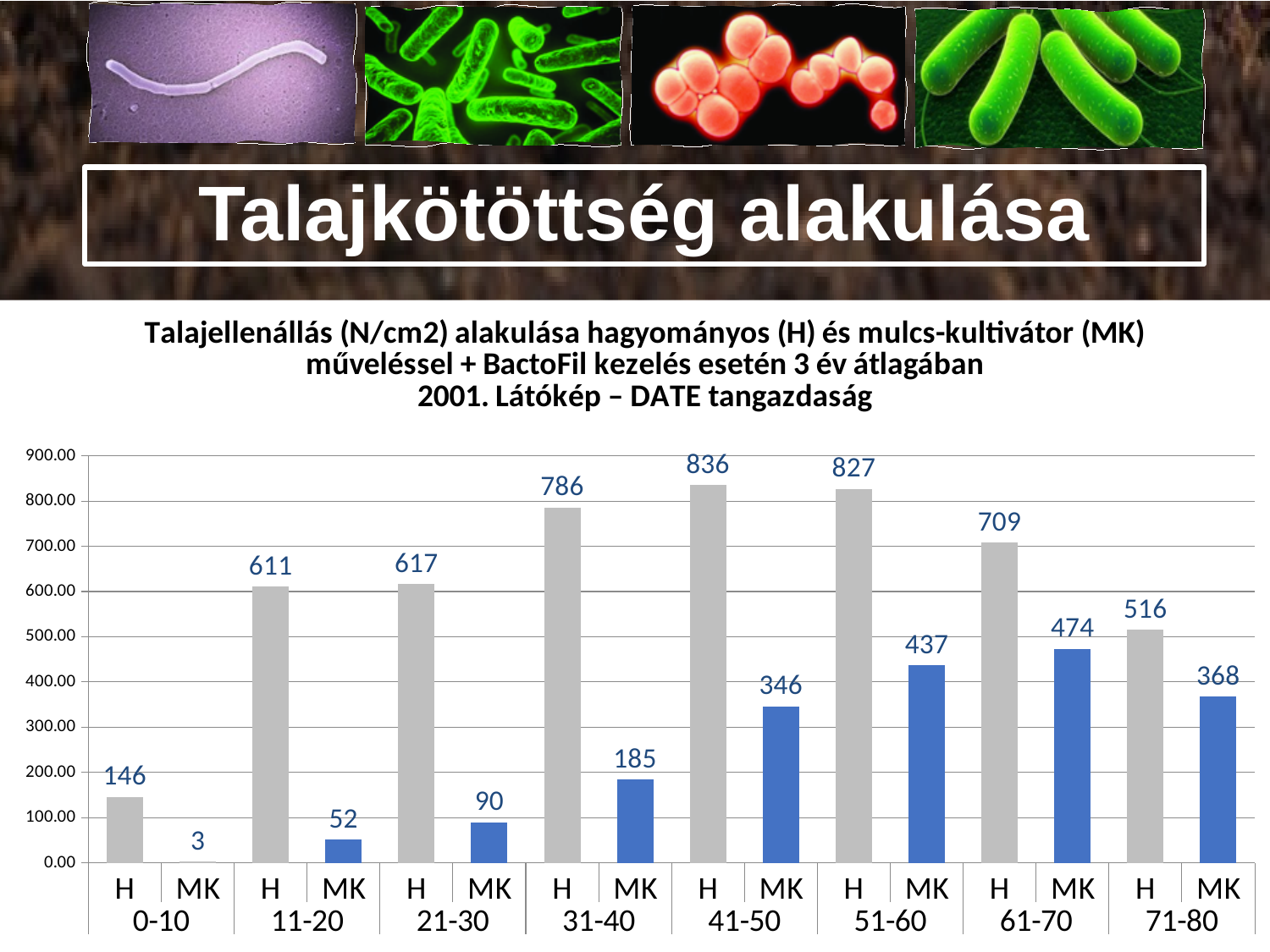
What is the value for H in the 31-40 depth range? 786 Is the H value for 71-80 greater or less than 500? greater Which is larger, the MK value for 41-50 or the MK value for 71-80? 71-80 What is the difference between the H and MK values in the 61-70 depth range? 235 Do the MK values rise or fall from the 0-10 range to the 61-70 range? rise What kind of chart is shown on the slide? bar chart How many depth ranges are shown on the x axis? 8 What is the value for MK in the 51-60 depth range? 437 Which depth range has the lowest MK value? 0-10 Which depth range has the highest H value? 41-50 What is the value for MK in the 0-10 depth range? 3 What colour are the MK bars? blue